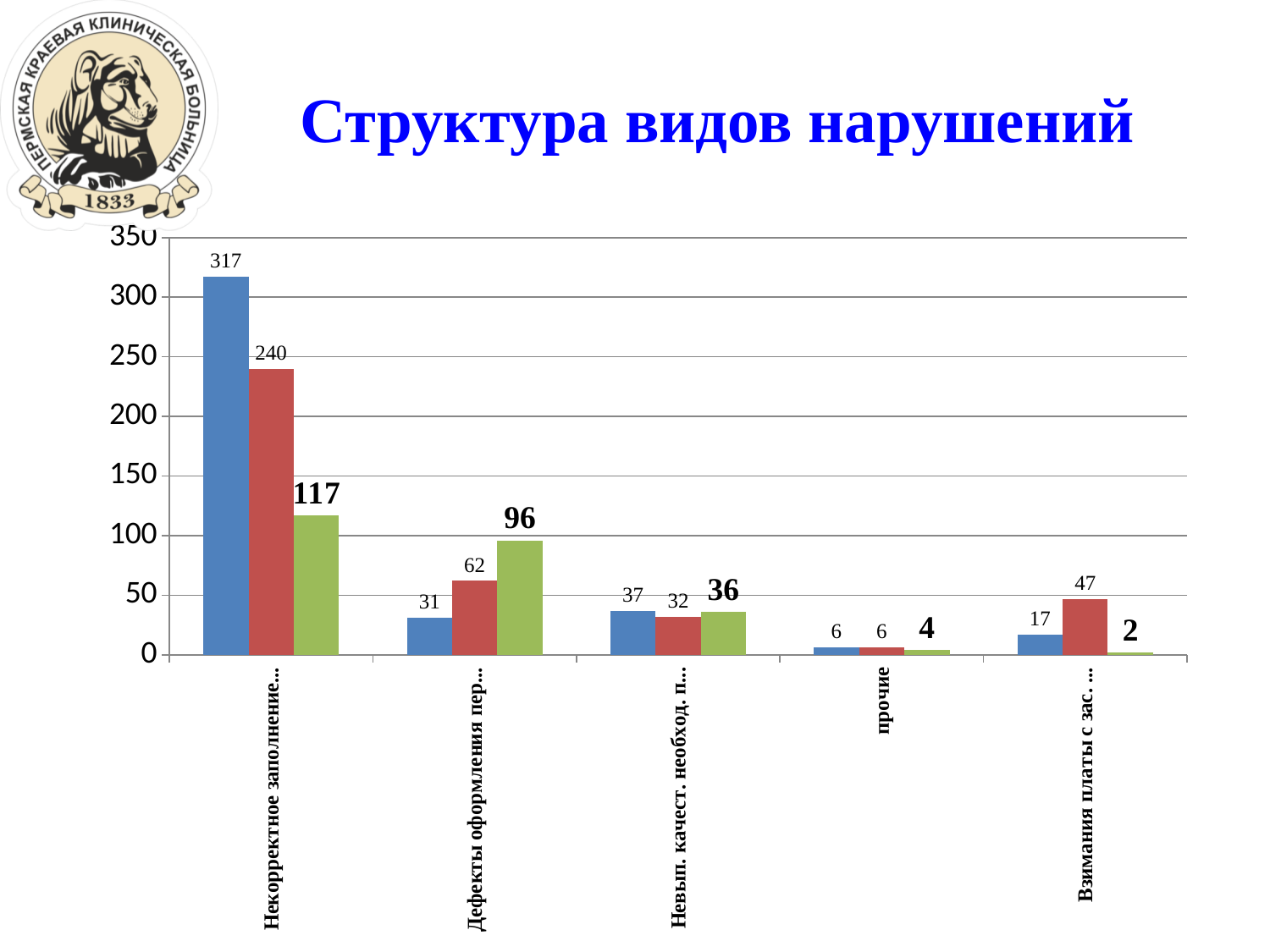
Which category has the lowest green bar? Взимания платы с зас. ... Which category has the highest blue bar? Некорректное заполнение... What is the title of the slide? Структура видов нарушений What is the value of the green bar for the category beginning "Дефекты оформления"? 96 What is the value of the red bar for the category beginning "Взимания платы с зас."? 47 For the category beginning "Дефекты оформления", which is larger: the blue bar or the red bar? the red bar How many categories are shown on the x axis? 5 What is the value of the blue bar for the category "прочие"? 6 What is the value of the blue bar for the category beginning "Некорректное заполнение"? 317 What kind of chart is shown on the slide? bar chart What is the value of the green bar for the category "прочие"? 4 What is the difference between the blue bar (317) and the red bar (240) for the category beginning "Некорректное заполнение"? 77